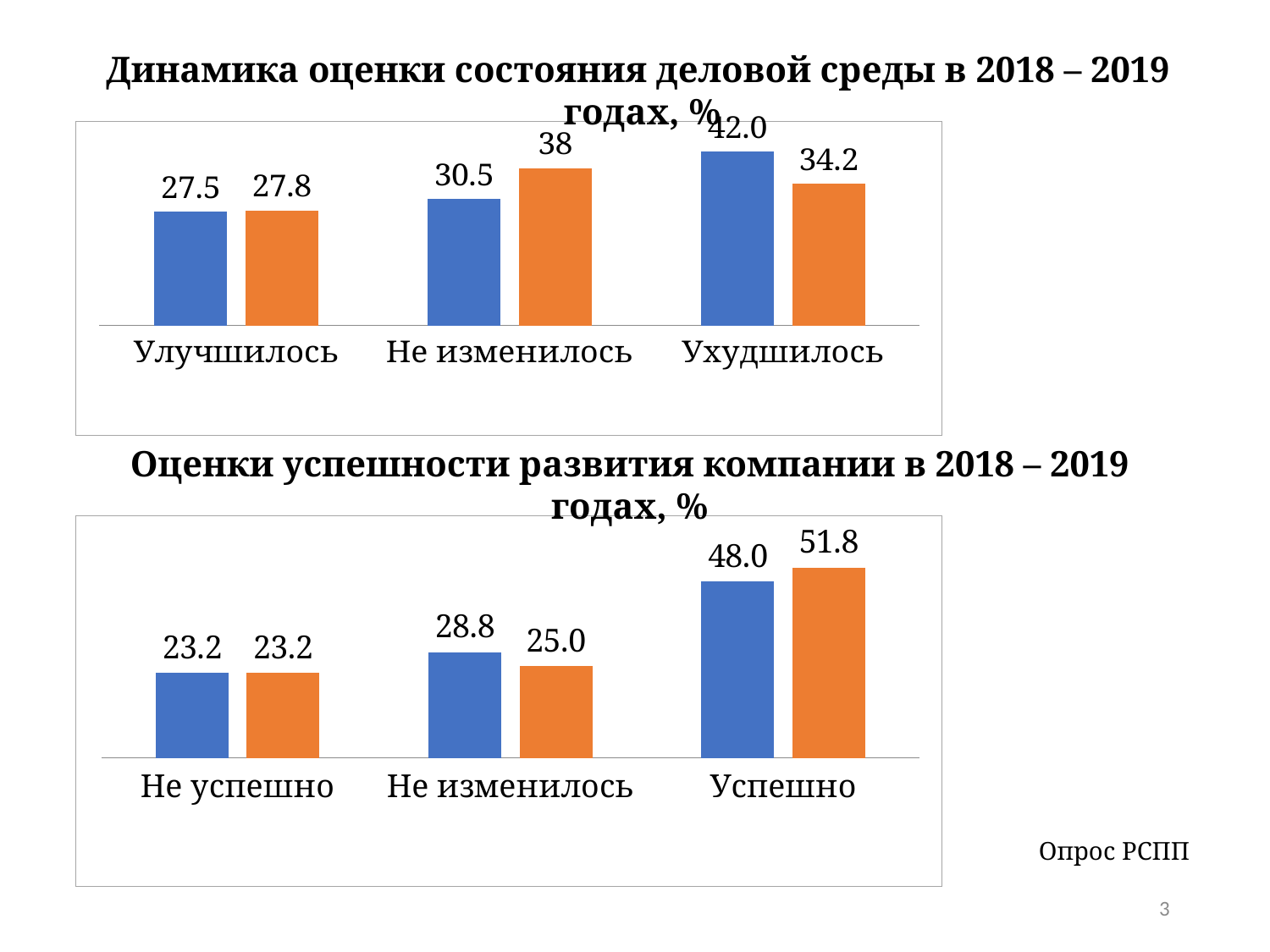
In the top chart (Динамика оценки состояния деловой среды), what is the difference between the blue and orange bars for Ухудшилось? 7.8 What type of chart is the bottom chart (Оценки успешности развития компании)? bar chart In the top chart (Динамика оценки состояния деловой среды), how many categories are shown on the x axis? 3 In the bottom chart (Оценки успешности развития компании), what is the value of the orange bar for Успешно? 51.8 In the top chart (Динамика оценки состояния деловой среды), what is the value of the orange bar for Не изменилось? 38 In the bottom chart (Оценки успешности развития компании), which is larger for Не изменилось, the blue bar or the orange bar? the blue bar In the bottom chart (Оценки успешности развития компании), what is the difference between the orange and blue bars for Успешно? 3.8 In the top chart (Динамика оценки состояния деловой среды), which category has the highest blue bar? Ухудшилось In the bottom chart (Оценки успешности развития компании), which category has the highest orange bar? Успешно In the top chart (Динамика оценки состояния деловой среды), which category has the lowest orange bar? Улучшилось In the bottom chart (Оценки успешности развития компании), what is the value of the blue bar for Не изменилось? 28.8 In the top chart (Динамика оценки состояния деловой среды), what is the value of the blue bar for Ухудшилось? 42.0